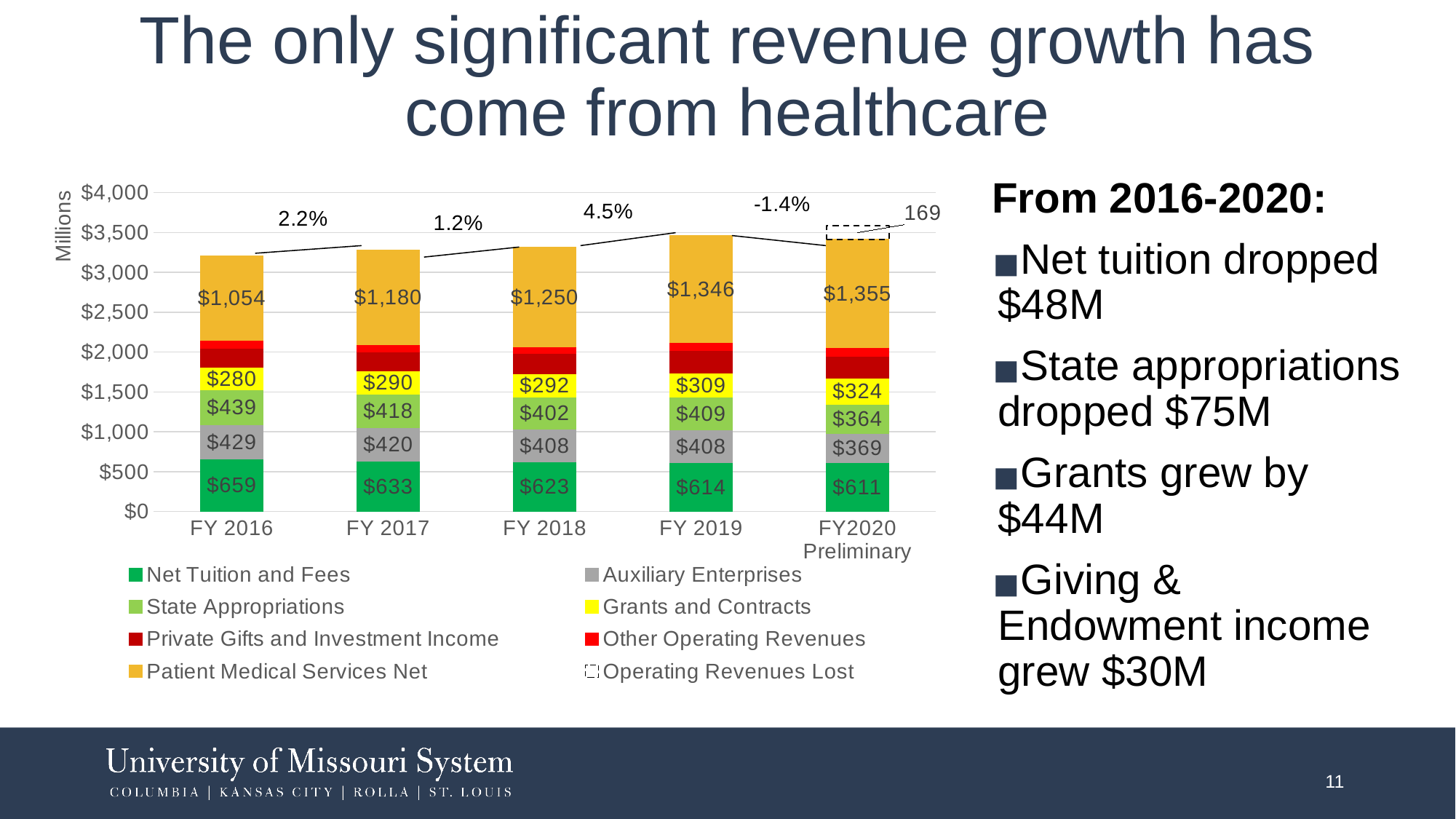
In which fiscal year is State Appropriations the lowest? FY2020 Preliminary How many fiscal years are shown on the x axis of the chart? 5 What is the value of Grants and Contracts in FY2020 Preliminary? $324 How many series does the chart legend list? 8 What percentage change is shown between the FY 2018 and FY 2019 bars? 4.5% What type of chart is shown on the slide? Stacked bar chart What is the value of Patient Medical Services Net in FY 2019? $1,346 Does Net Tuition and Fees rise or fall from FY 2016 to FY2020 Preliminary? Fall What is the difference between Net Tuition and Fees in FY 2016 and in FY2020 Preliminary? $48 Which is larger in FY 2017: State Appropriations or Auxiliary Enterprises? Auxiliary Enterprises In which fiscal year is Patient Medical Services Net the highest? FY2020 Preliminary What is the value of Net Tuition and Fees in FY 2016? $659